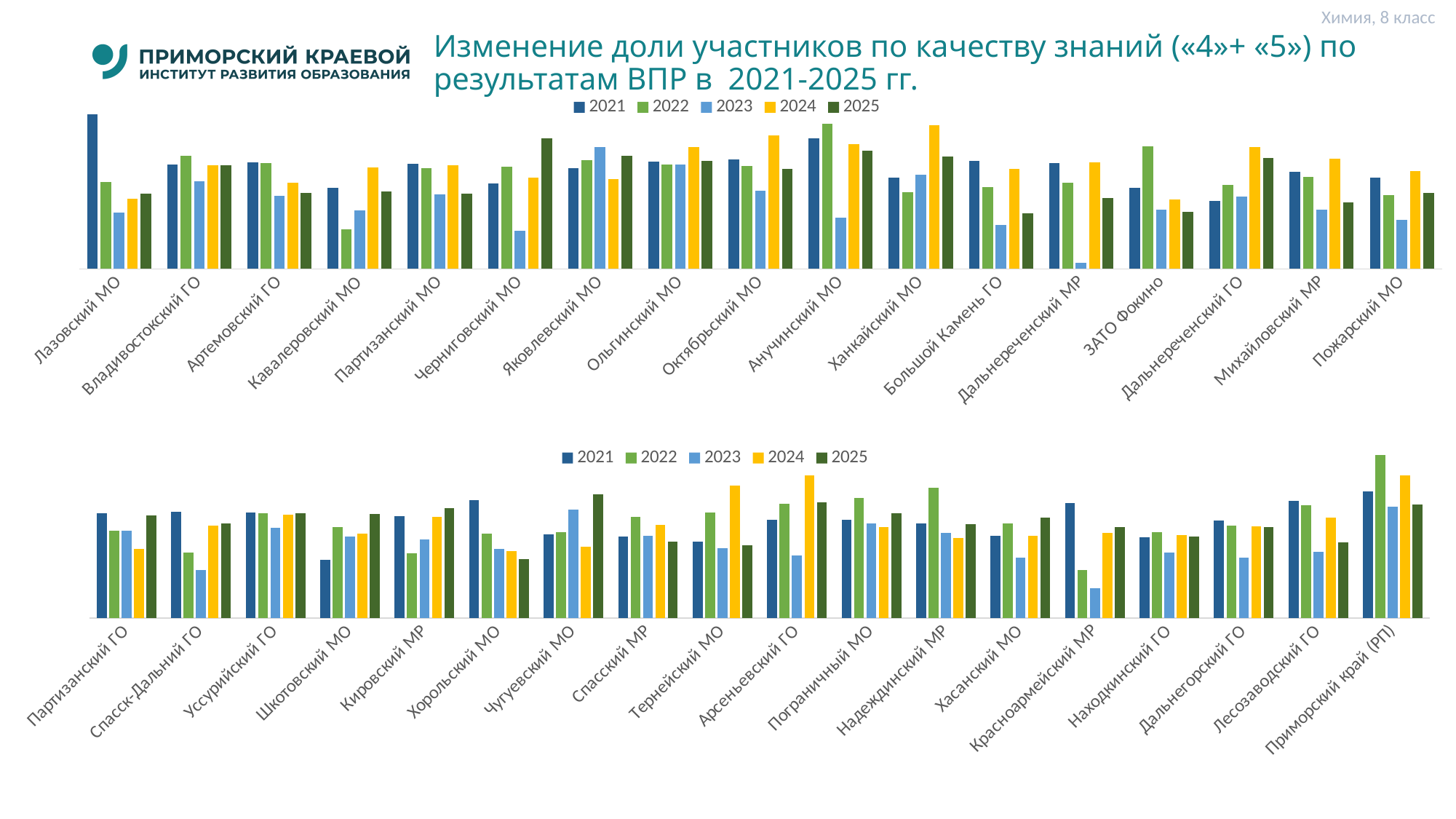
In the top chart, which is larger for Лазовский МО: the 2021 value or the 2023 value? 2021 In the bottom chart, which is larger for Приморский край (РП): the 2022 value or the 2023 value? 2022 How many categories are shown on the x axis of the bottom chart? 18 In the bottom chart, which year has the lowest value for Красноармейский МР? 2023 What colour represents the 2024 series in the legend? yellow In the top chart, which category has the tallest bar overall? Лазовский МО How many categories are shown on the x axis of the top chart? 17 In the bottom chart, which category has the tallest bar overall? Приморский край (РП) What kind of chart is the top chart on the slide? bar chart How many series does the legend of the top chart list? 5 In the top chart, which year has the highest value for Ханкайский МО? 2024 In the top chart, do the values for Лазовский МО rise or fall from 2021 to 2023? fall